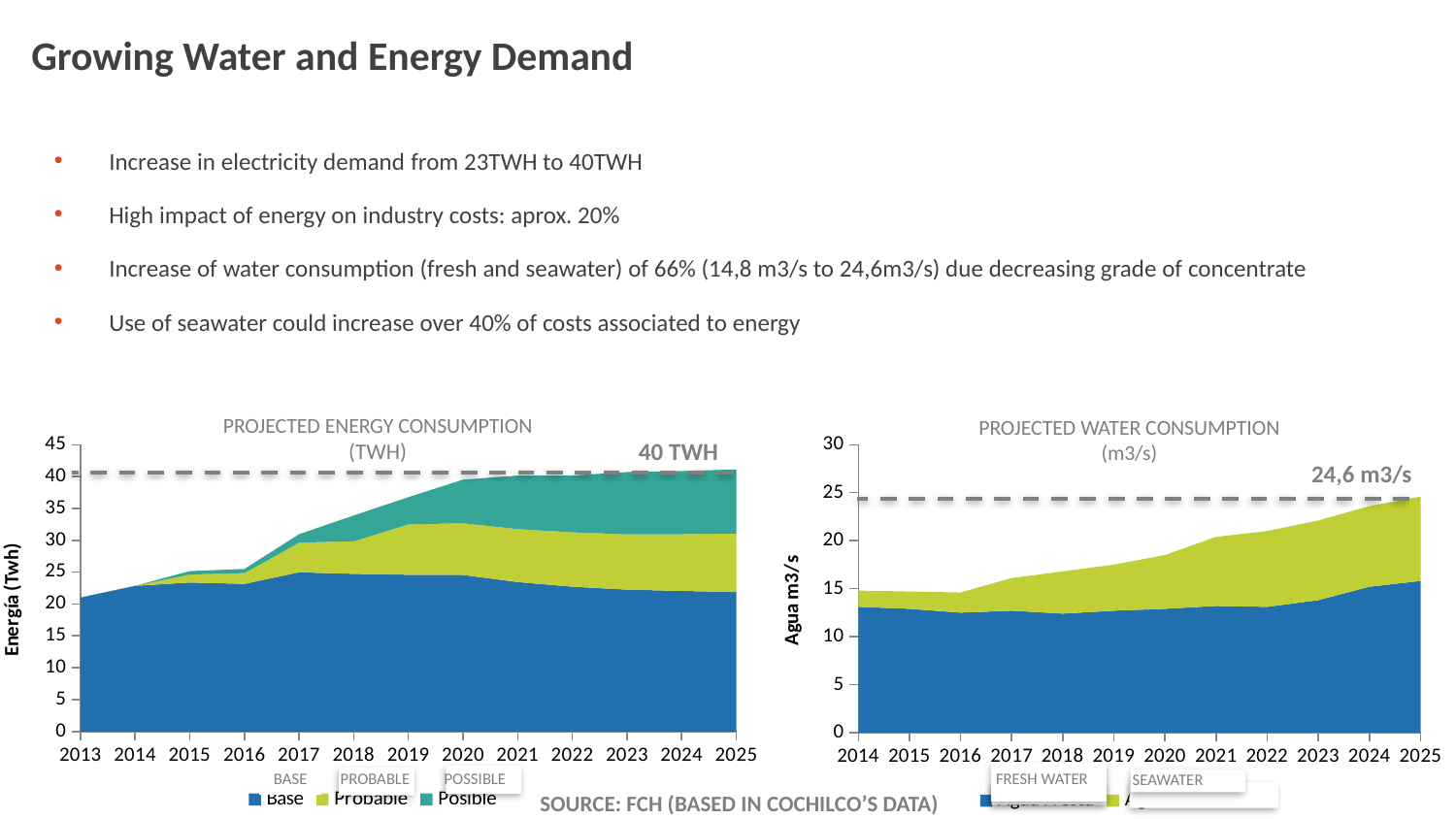
What value does the annotation on the Projected Energy Consumption chart give for 2025? 40 TWH What value does the annotation on the Projected Water Consumption chart give for 2025? 24,6 m3/s In the Projected Energy Consumption chart, is the total value for 2025 greater or less than 35? greater What kind of chart is the Projected Energy Consumption chart on the left? stacked area chart In the Projected Water Consumption chart, is the total value for 2014 greater or less than 20? less In the Projected Water Consumption chart, does the total water consumption rise or fall from 2014 to 2025? rise How many series does the legend of the Projected Water Consumption chart list? 2 In the Projected Energy Consumption chart, is the total value for 2013 greater or less than 25? less How many years are shown on the x axis of the Projected Water Consumption chart? 12 In the Projected Energy Consumption chart, does the total consumption rise or fall from 2013 to 2025? rise How many years are shown on the x axis of the Projected Energy Consumption chart? 13 How many series does the legend of the Projected Energy Consumption chart list? 3